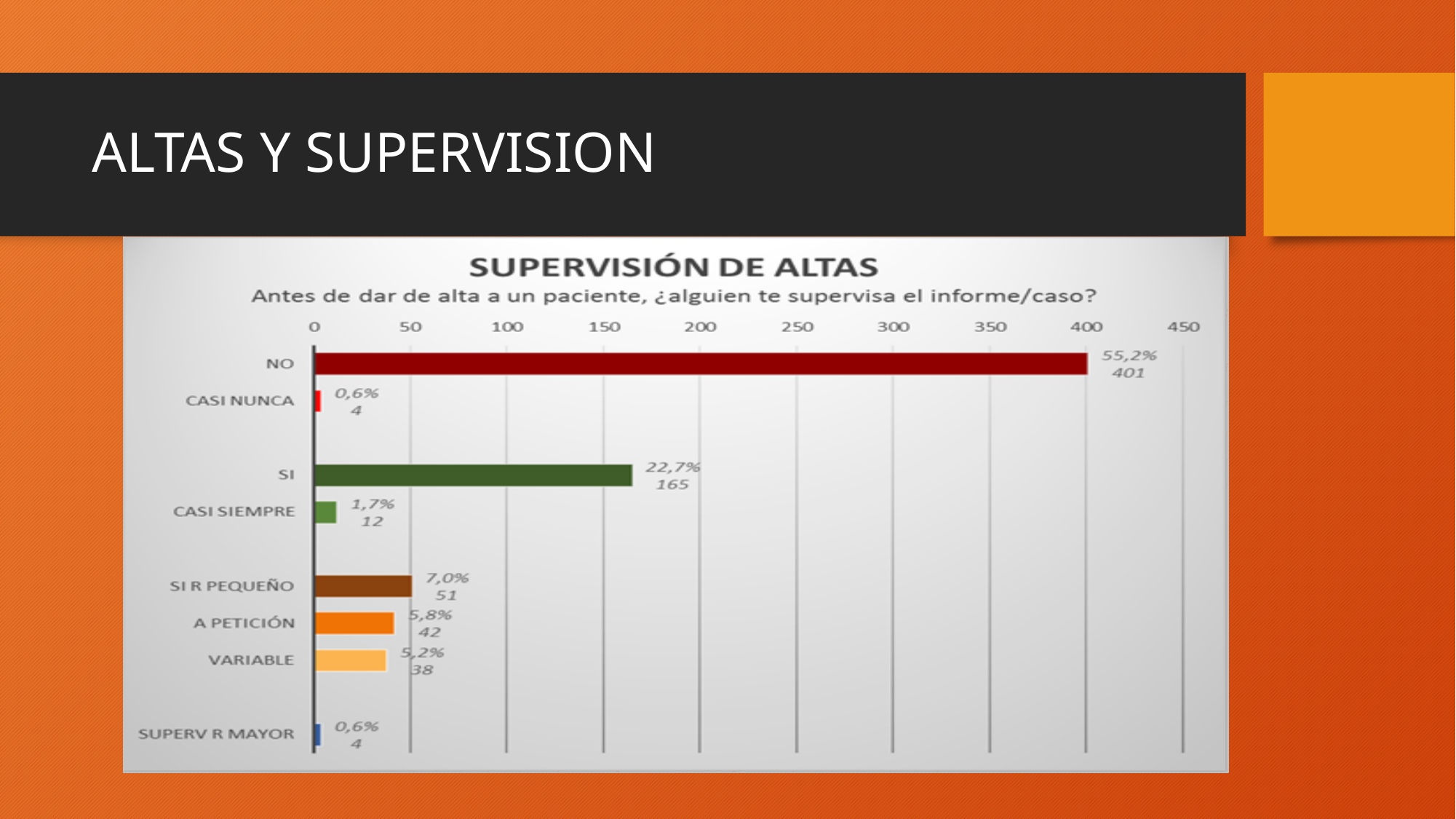
What kind of chart is shown on the slide? bar chart What percentage is shown for VARIABLE? 5,2% What is the difference between the counts for CASI SIEMPRE and CASI NUNCA? 8 How many categories are plotted in the chart? 8 Which is larger, the value for SI R PEQUEÑO or the value for A PETICIÓN? SI R PEQUEÑO What is the title of the chart? SUPERVISIÓN DE ALTAS Which category has the highest value? NO Is the value for SI greater or less than 200? less What is the count shown for the NO category? 401 What is the difference between the counts for NO and SI? 236 What is the count shown for A PETICIÓN? 42 What percentage is shown for the SI category? 22,7%